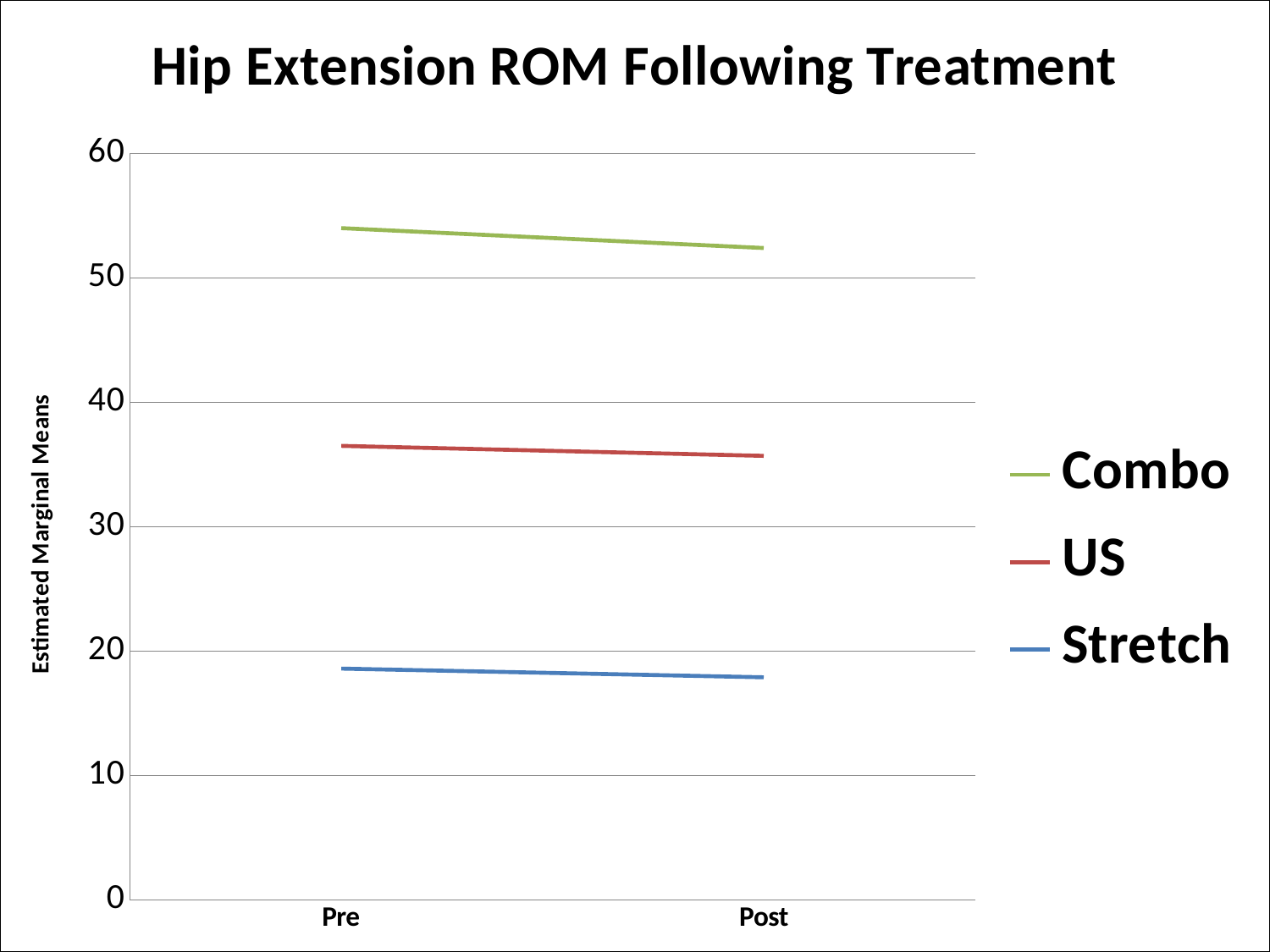
What kind of chart is shown on the slide? line chart Do the values for Combo rise or fall from Pre to Post? fall Which series has the lowest values? Stretch Is the value for Combo at Pre greater or less than 50? greater Which series has the highest values? Combo What is the label of the y axis? Estimated Marginal Means Which is larger, the US value at Pre or the Stretch value at Pre? US Is the value for Stretch at Pre greater or less than 20? less Is the value for US at Post greater or less than 40? less What is the title of the chart? Hip Extension ROM Following Treatment How many categories are shown on the x axis? 2 How many series does the legend list? 3